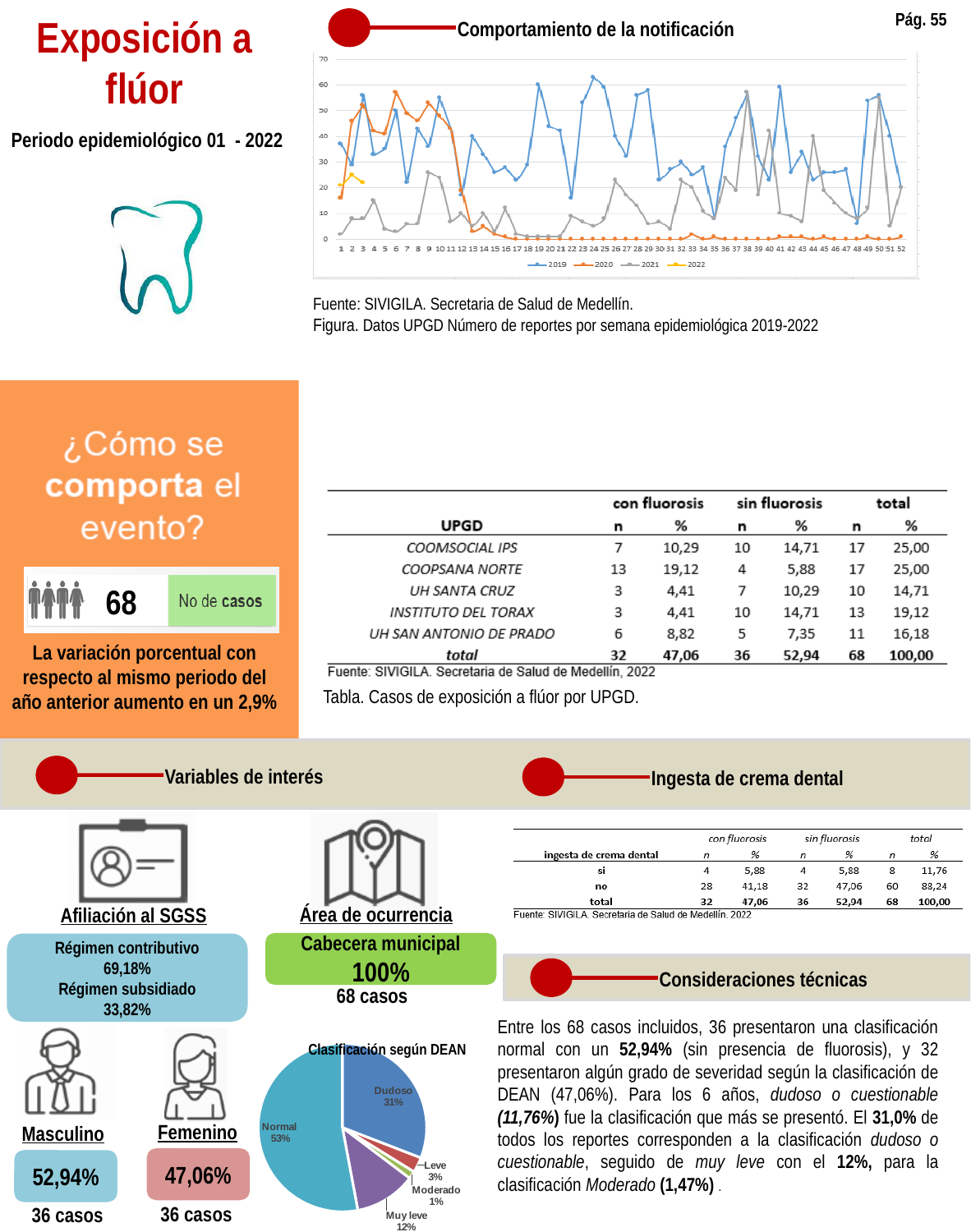
In the 'Clasificación según DEAN' pie chart, what is the difference in percentage points between Normal and Dudoso? 22 In the 'Comportamiento de la notificación' chart, which years are listed in the legend? 2019, 2020, 2021, 2022 In the 'Clasificación según DEAN' pie chart, what is the value for Dudoso? 31% In the 'Comportamiento de la notificación' chart, is the value for 2021 at week 1 greater or less than 10? less What kind of chart is the 'Clasificación según DEAN' chart at the bottom of the slide? pie chart In the 'Clasificación según DEAN' pie chart, which category has the smallest slice? Moderado In the 'Clasificación según DEAN' pie chart, how many slices are there? 5 In the 'Clasificación según DEAN' pie chart, what share does the Normal slice have? 53% What kind of chart is the 'Comportamiento de la notificación' chart at the top of the slide? line chart In the 'Comportamiento de la notificación' chart, is the value for 2019 at week 24 greater or less than 50? greater In the 'Comportamiento de la notificación' chart, is the value for 2020 at week 20 greater or less than 10? less How many series does the legend of the 'Comportamiento de la notificación' chart list? 4